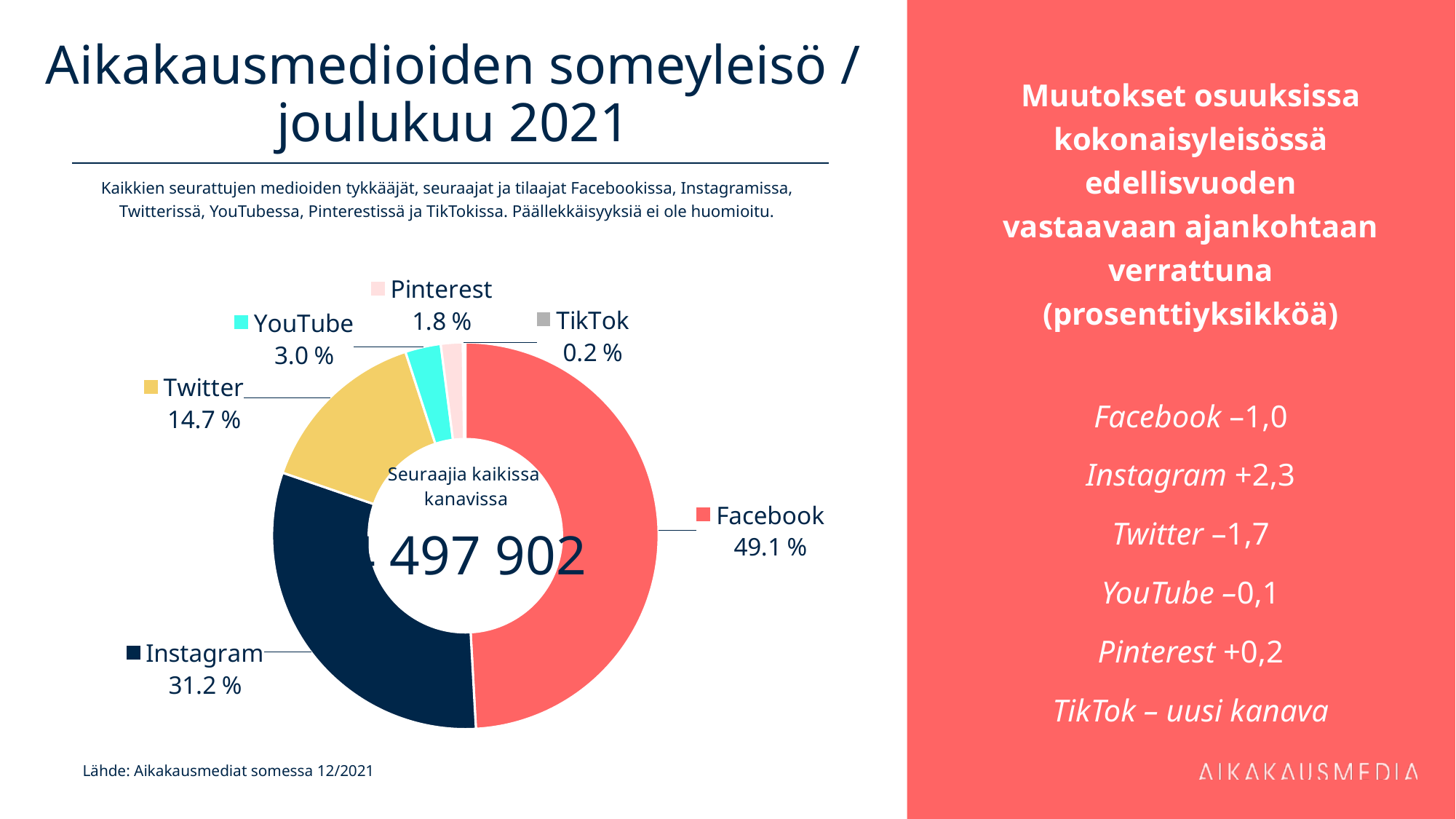
What share of the social media audience does TikTok hold? 0.2 % What colour is the Twitter slice in the chart? Yellow What share of the social media audience does YouTube hold? 3.0 % What is the difference in percentage points between Facebook's and Instagram's shares? 17.9 What share of the social media audience does Twitter hold? 14.7 % How many channels are shown in the chart? 6 What type of chart is shown on the slide? Pie chart (donut) What share of the social media audience does Facebook hold? 49.1 % Which has a larger share, Twitter or YouTube? Twitter Which channel has the largest share of the audience? Facebook What share of the social media audience does Instagram hold? 31.2 % Which channel has the smallest share of the audience? TikTok